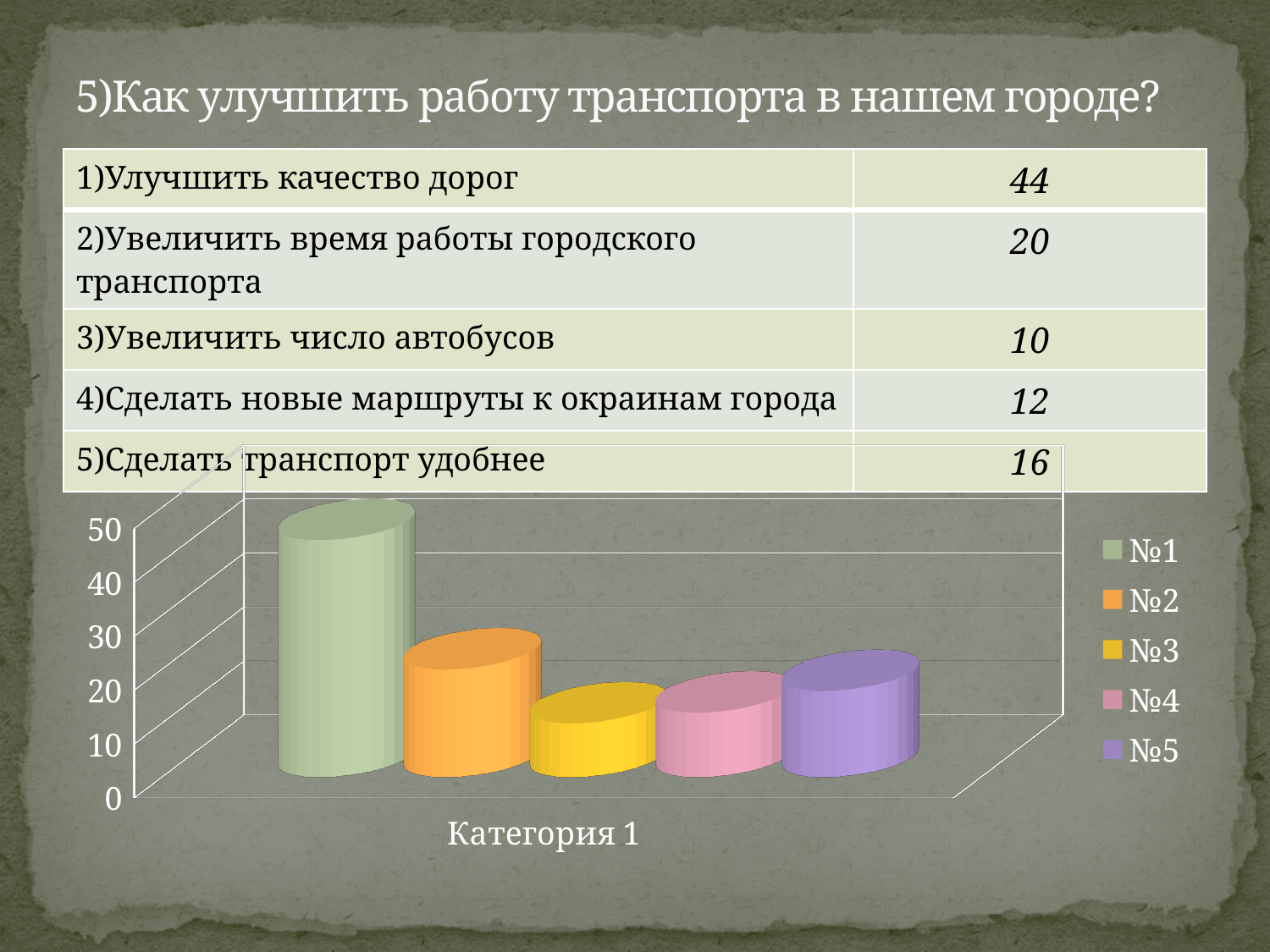
Using the values in the table, what is the difference between option 1 and option 2? 24 What is the highest value shown on the chart's vertical axis? 50 Is the value for series №3 greater or less than 20? less Which series has the tallest bar in the chart? №1 According to the table above the chart, what is the value for option 5 (Сделать транспорт удобнее)? 16 According to the table above the chart, what is the value for option 1 (Улучшить качество дорог)? 44 Is the value for series №1 greater or less than 30? greater What kind of chart is shown on the slide? bar chart How many categories are shown on the x axis of the chart? 1 What is the label of the category on the x axis of the chart? Категория 1 Which bar is taller, series №2 or series №5? №2 How many series does the chart legend list? 5